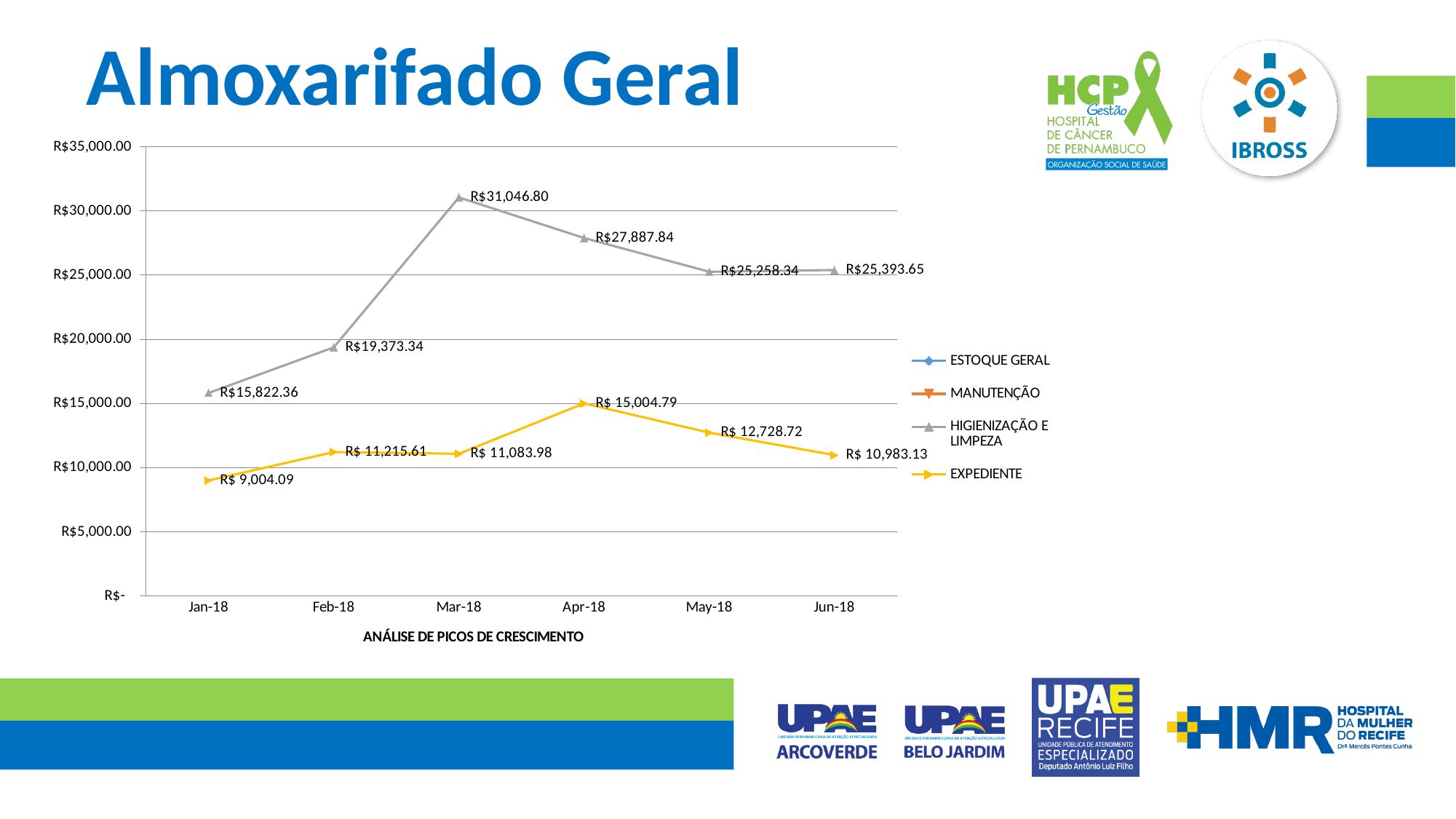
Which is larger in May-18: HIGIENIZAÇÃO E LIMPEZA or EXPEDIENTE? HIGIENIZAÇÃO E LIMPEZA What type of chart is shown on the slide? Line chart In which month does EXPEDIENTE have its lowest value? Jan-18 What is the value for HIGIENIZAÇÃO E LIMPEZA in Mar-18? R$31,046.80 Does the EXPEDIENTE line rise or fall from Apr-18 to Jun-18? Fall How many series does the legend list? 4 What is the value for HIGIENIZAÇÃO E LIMPEZA in Jun-18? R$25,393.65 In which month does HIGIENIZAÇÃO E LIMPEZA reach its highest value? Mar-18 What is the difference between HIGIENIZAÇÃO E LIMPEZA and EXPEDIENTE in Mar-18? R$19,962.82 How many months are shown on the x axis? 6 What is the value for EXPEDIENTE in Apr-18? R$ 15,004.79 What is the value for EXPEDIENTE in Jan-18? R$ 9,004.09